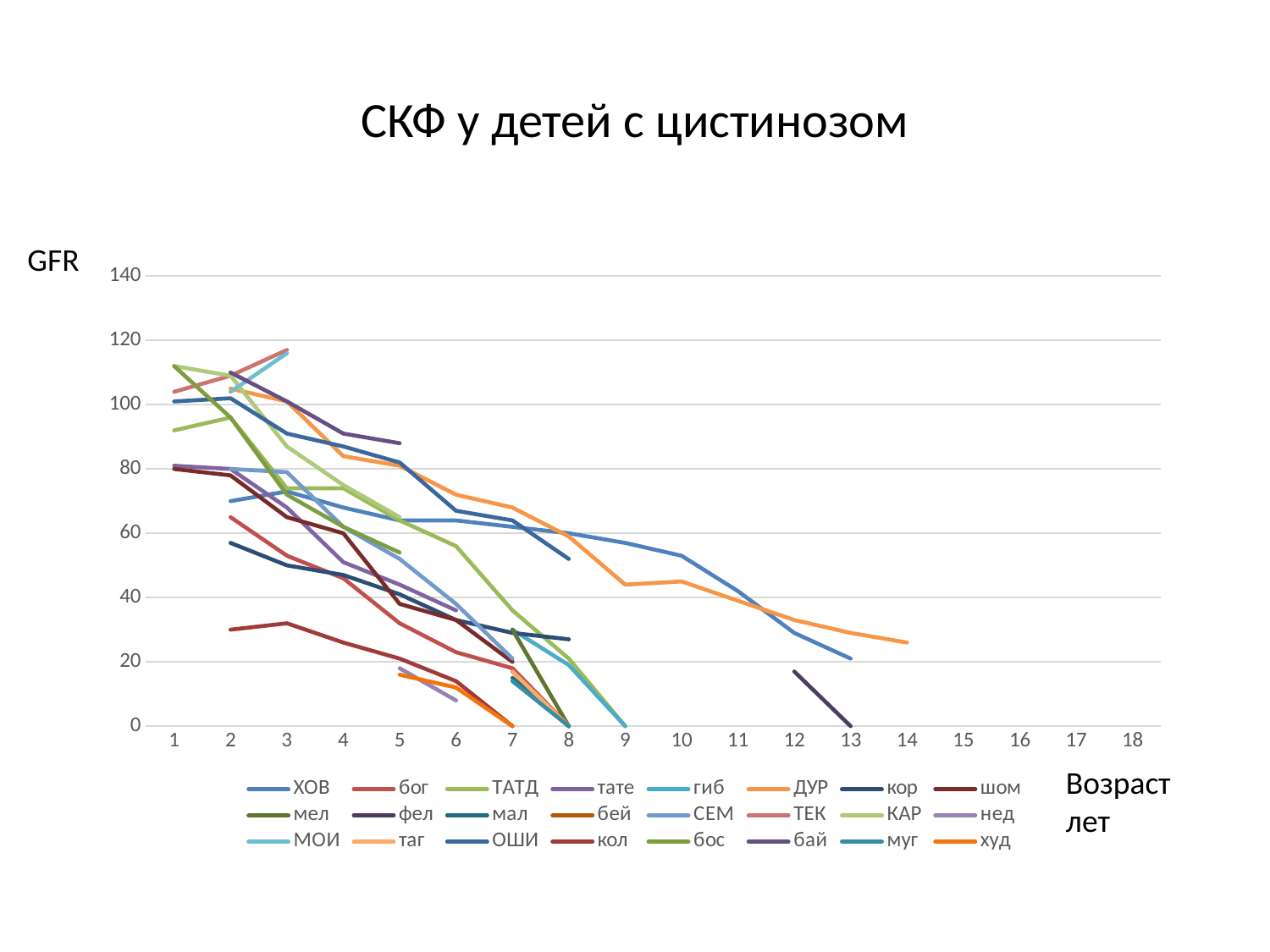
Do the GFR values generally rise or fall as age increases? fall Is the lowest value plotted at age 2 greater or less than 40? less Is the value of the line that ends at age 13 at around 20 greater or less than 40? less What kind of chart is shown on the slide? line chart What is the highest value shown on the vertical axis? 140 What is the title of the chart? СКФ у детей с цистинозом Is the highest value plotted at age 3 greater or less than 100? greater How many series does the legend list? 24 Up to what age does the longest line on the chart extend? 14 How many age values are marked along the x axis? 18 What is the label of the vertical axis? GFR